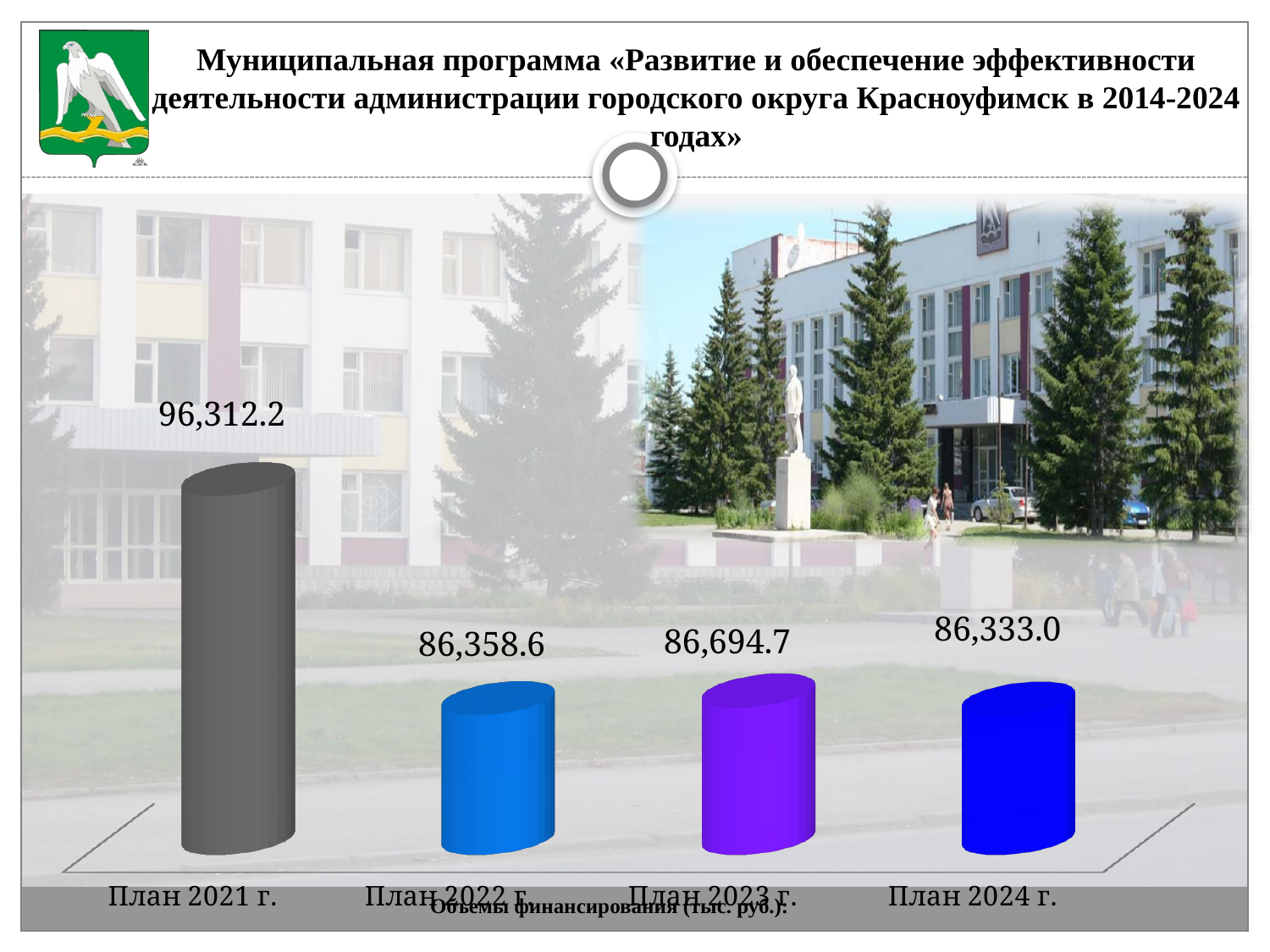
What is the difference between the values for План 2021 г. and План 2022 г.? 9,953.6 Which category has the lowest value? План 2024 г. What colour is the bar for План 2021 г.? Gray What is the value for План 2023 г.? 86,694.7 Which category has the highest value? План 2021 г. How many categories are shown in the chart? 4 Which is larger, the value for План 2023 г. or План 2022 г.? План 2023 г. What is the value for План 2024 г.? 86,333.0 What is the value for План 2021 г.? 96,312.2 What kind of chart is shown on the slide? Bar chart What is the value for План 2022 г.? 86,358.6 What is the difference between the values for План 2023 г. and План 2024 г.? 361.7